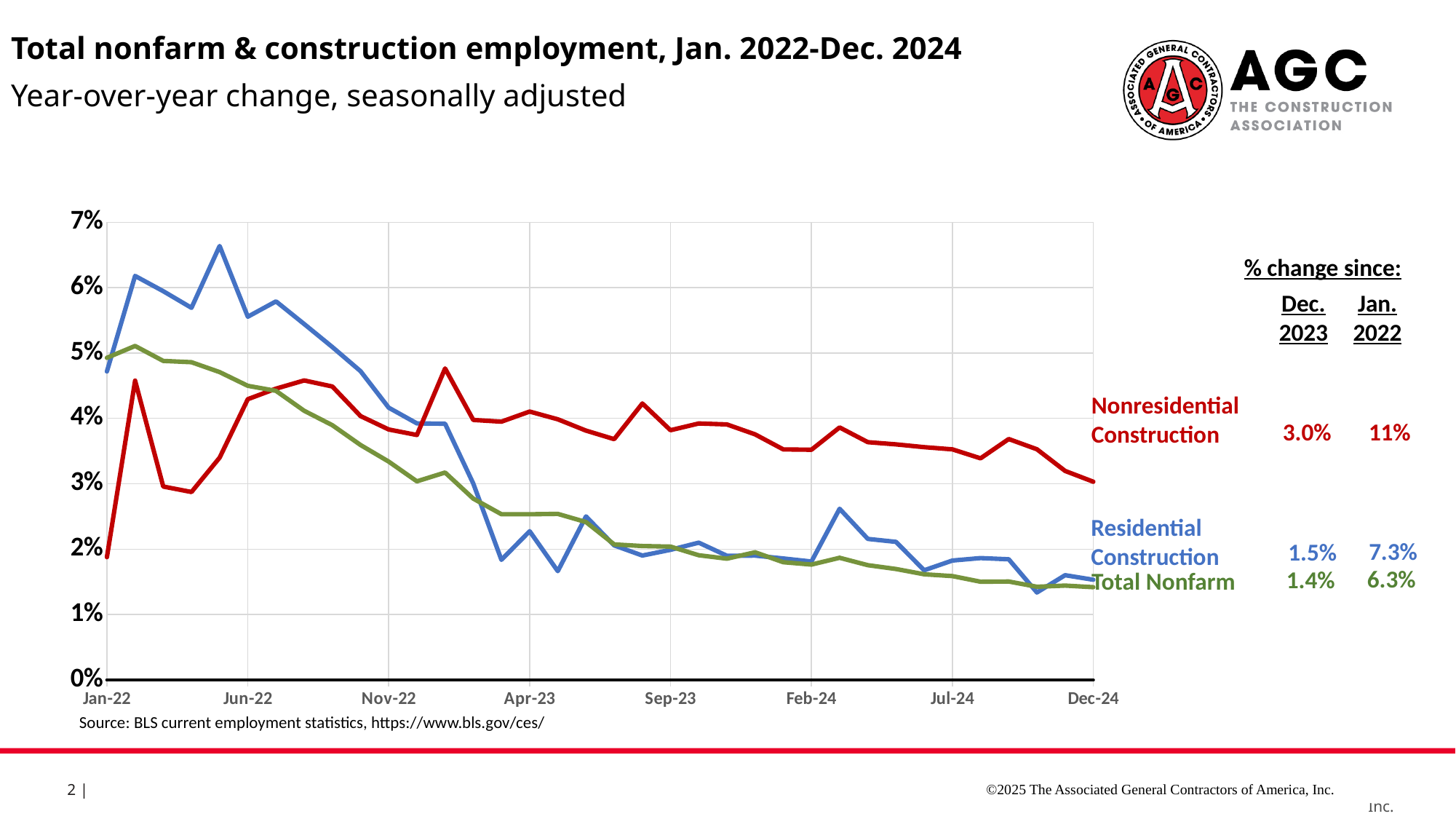
What colour is the Nonresidential Construction line? red Which series has the lowest % change since Jan. 2022? Total Nonfarm What kind of chart is shown on the slide? line chart Does the Total Nonfarm line generally rise or fall from Jan-22 to Dec-24? fall Which series has the highest % change since Jan. 2022? Nonresidential Construction What is the % change since Dec. 2023 for Nonresidential Construction? 3.0% What is the difference between the % change since Dec. 2023 for Nonresidential Construction and for Residential Construction? 1.5% Which is larger, the % change since Dec. 2023 for Residential Construction or for Total Nonfarm? Residential Construction How many data series are plotted on the chart? 3 Is the value for Nonresidential Construction at Apr-23 greater or less than 3%? greater What is the % change since Dec. 2023 for Total Nonfarm? 1.4% What is the % change since Jan. 2022 for Residential Construction? 7.3%